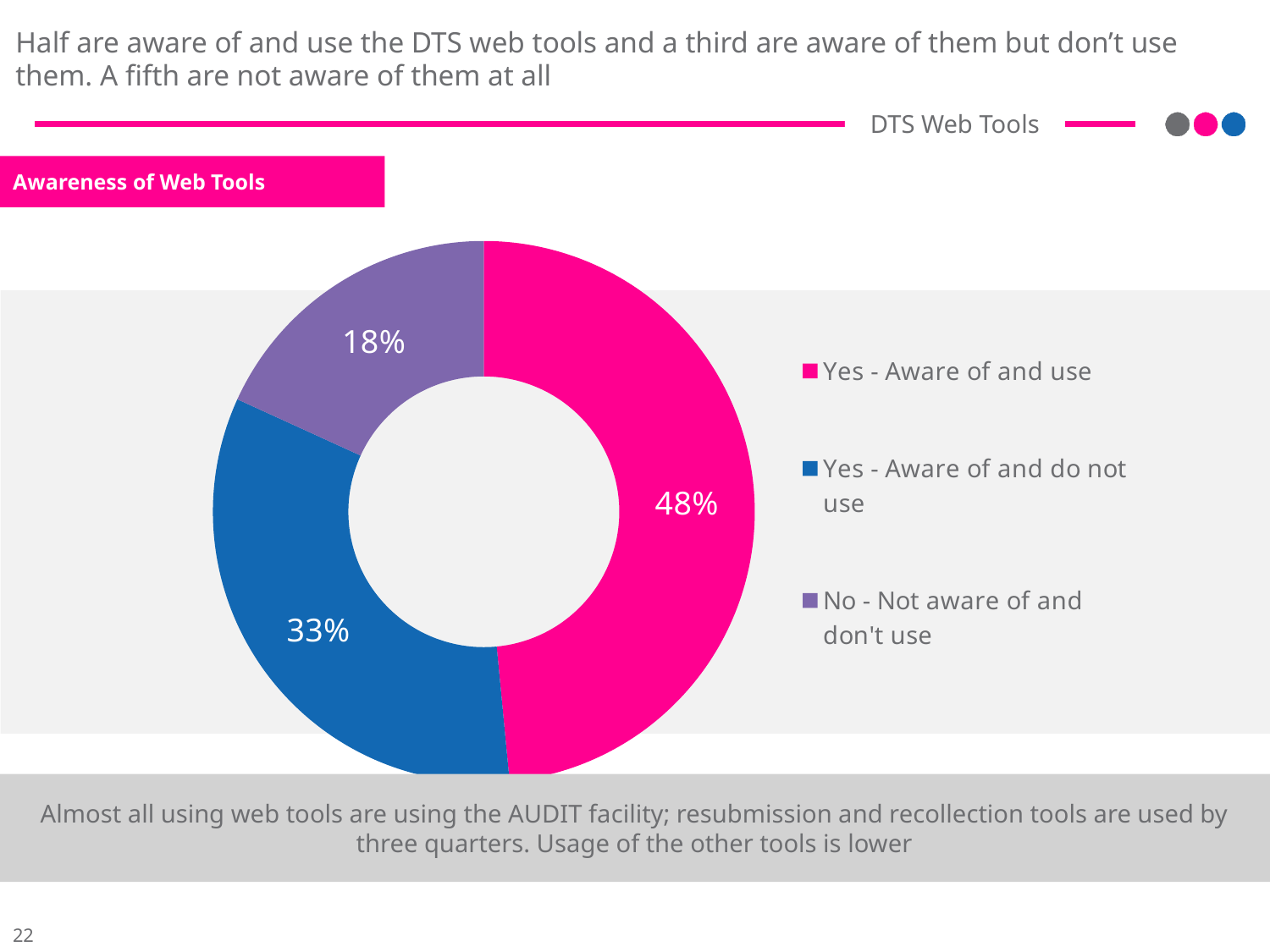
What kind of chart is shown on the slide? Pie chart (doughnut) What percentage of respondents are aware of and use the DTS web tools? 48% What is the difference in percentage points between 'Yes - Aware of and do not use' and 'No - Not aware of and don't use'? 15 Which category has the smallest share of the pie? No - Not aware of and don't use What colour is the 'Yes - Aware of and use' slice? Pink What percentage of respondents are aware of the web tools but do not use them? 33% How many categories are shown in the chart? 3 What is the difference in percentage points between 'Yes - Aware of and use' and 'Yes - Aware of and do not use'? 15 Which category has the largest share of the pie? Yes - Aware of and use What percentage of respondents are not aware of the web tools and don't use them? 18% Which is larger: the share for 'Yes - Aware of and do not use' or the share for 'No - Not aware of and don't use'? Yes - Aware of and do not use What is the title of the chart? Awareness of Web Tools